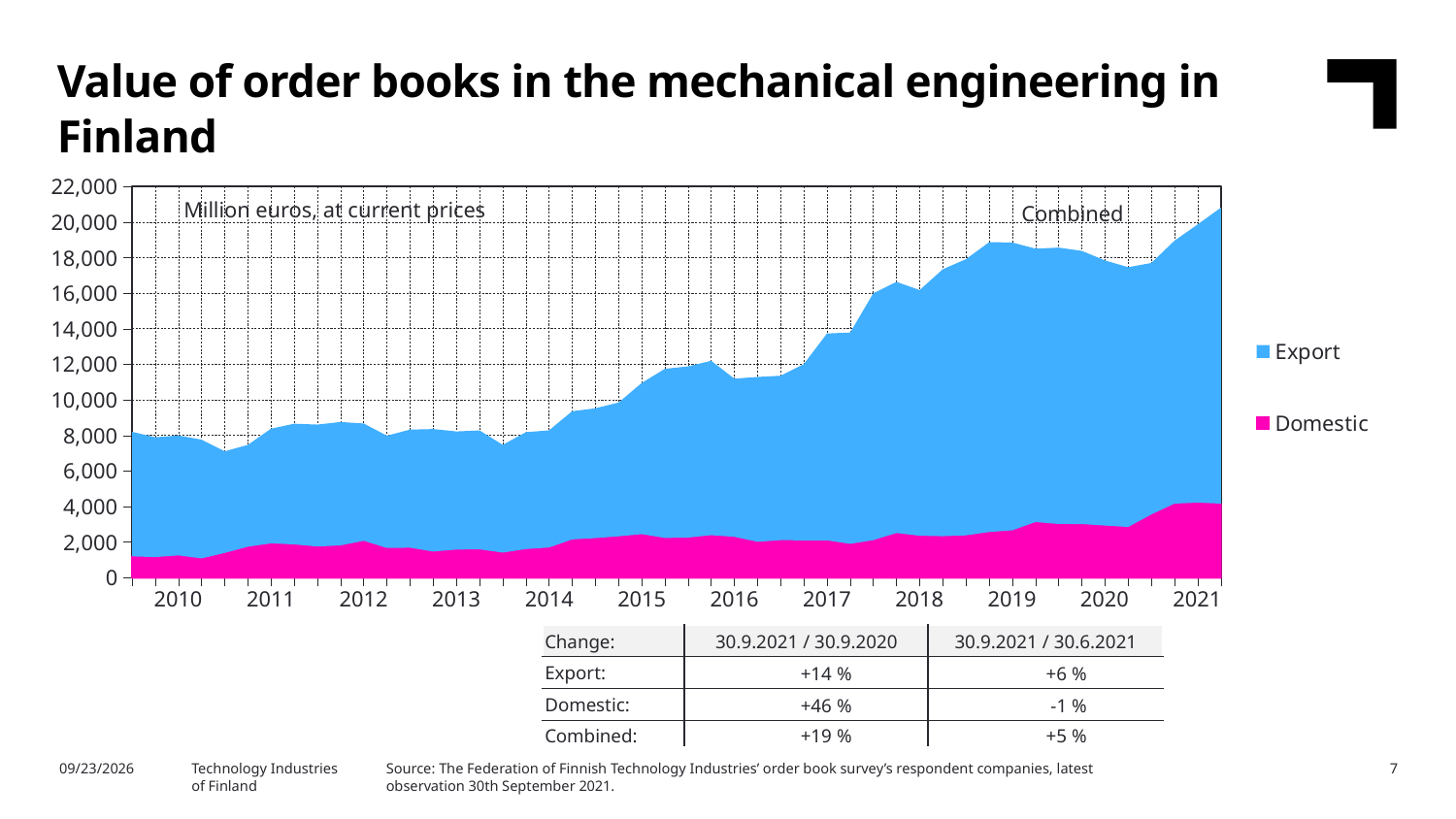
Is the combined value of order books at the end of 2021 greater or less than 18,000? greater Which series is larger throughout the chart, Export or Domestic? Export What kind of chart is shown on the slide? Area chart How many series does the chart legend list? 2 Does the combined value of order books generally rise or fall from 2010 to 2021? rise Is the Domestic value in 2010 greater or less than 2,000? less Is the combined value of order books in 2019 greater or less than 16,000? greater How many years are labelled on the x axis of the chart? 12 Which two series are listed in the chart legend? Export and Domestic What unit is stated on the chart for the values? Million euros, at current prices